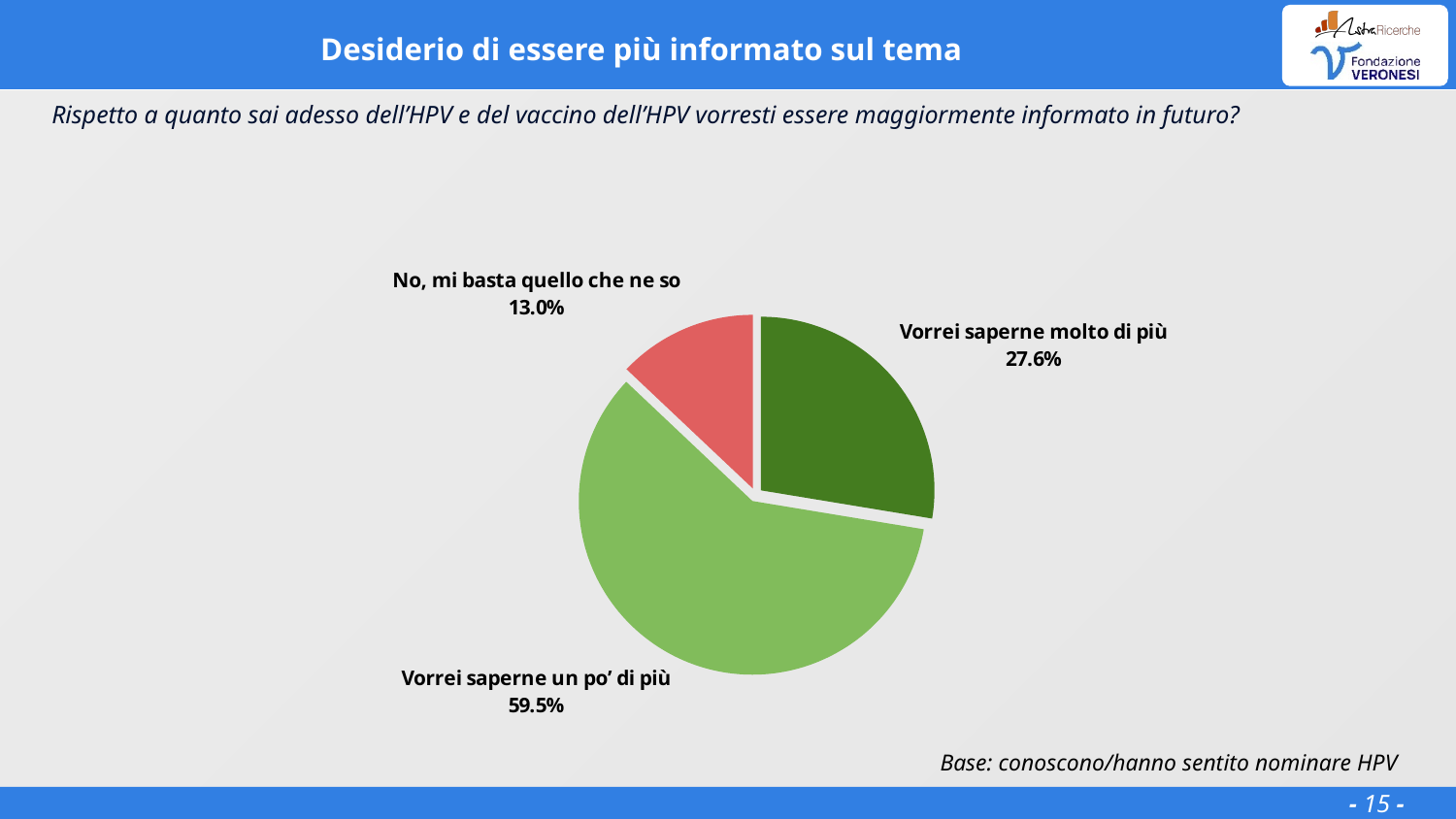
What kind of chart is shown on the slide? pie chart What is the difference in percentage points between "Vorrei saperne molto di più" and "No, mi basta quello che ne so"? 14.6 What is the difference in percentage points between "Vorrei saperne un po' di più" and "Vorrei saperne molto di più"? 31.9 Which response has the largest share of the pie? Vorrei saperne un po' di più What colour is the slice for "No, mi basta quello che ne so"? red What is the title of the slide containing the pie chart? Desiderio di essere più informato sul tema Which response has the smallest share of the pie? No, mi basta quello che ne so What percentage of respondents answered "Vorrei saperne un po' di più"? 59.5% What percentage of respondents answered "No, mi basta quello che ne so"? 13.0% How many slices does the pie chart have? 3 What percentage of respondents answered "Vorrei saperne molto di più"? 27.6% Which is larger: the share for "Vorrei saperne molto di più" or for "No, mi basta quello che ne so"? Vorrei saperne molto di più